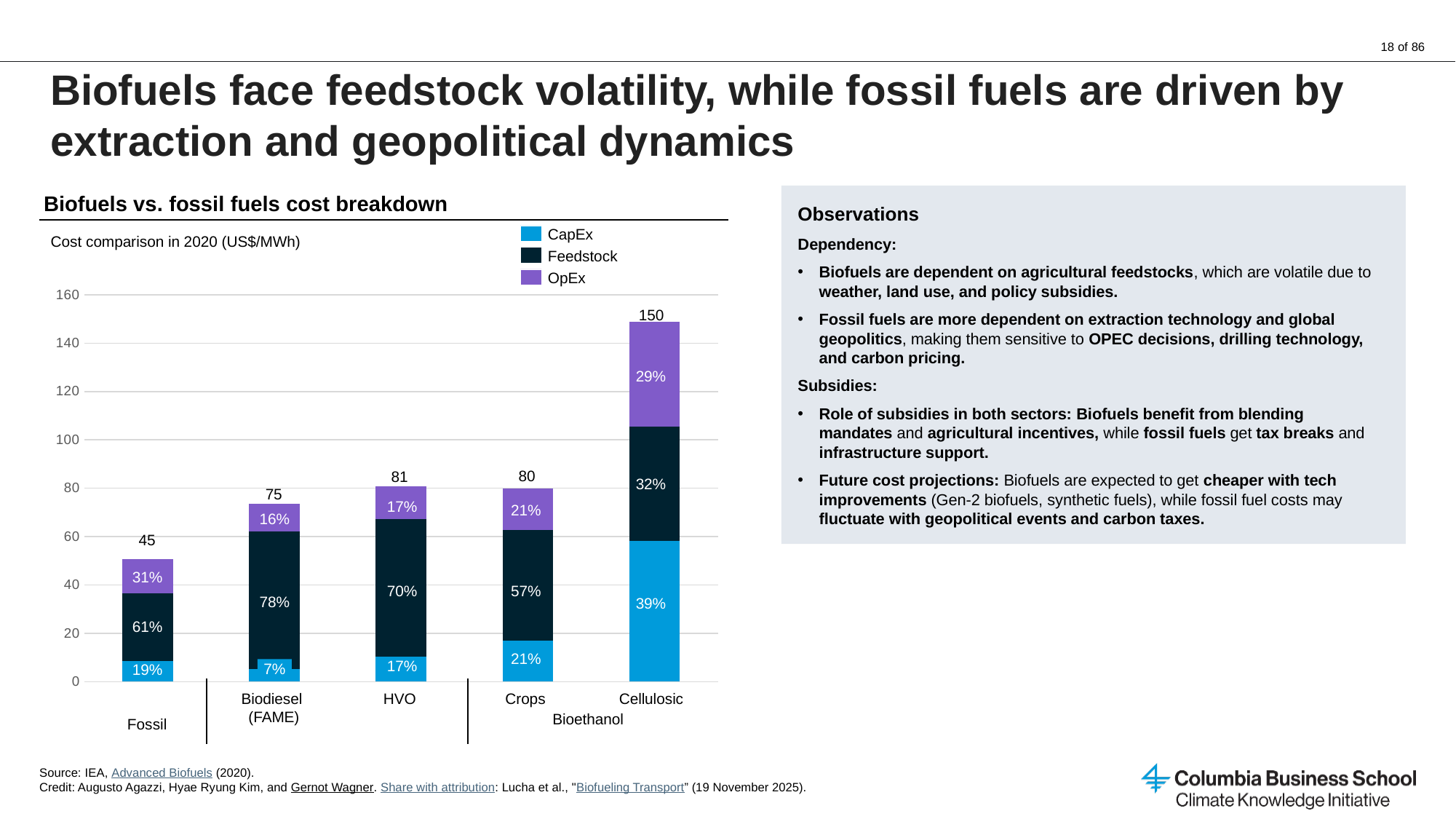
What is the difference between the total cost of Cellulosic and the total cost of Fossil? 105 What kind of chart is shown on the slide? Stacked bar chart What percentage of the Fossil cost is OpEx? 31% What percentage of the Biodiesel (FAME) cost is Feedstock? 78% What percentage of the Cellulosic cost is CapEx? 39% Which fuel category has the highest total cost? Cellulosic How many series does the chart legend list? 3 How many fuel categories are plotted in the chart? 5 In what units are the costs in the chart expressed? US$/MWh What is the total cost shown for Cellulosic bioethanol? 150 What is the total cost shown for Biodiesel (FAME)? 75 Which fuel category has the lowest total cost? Fossil